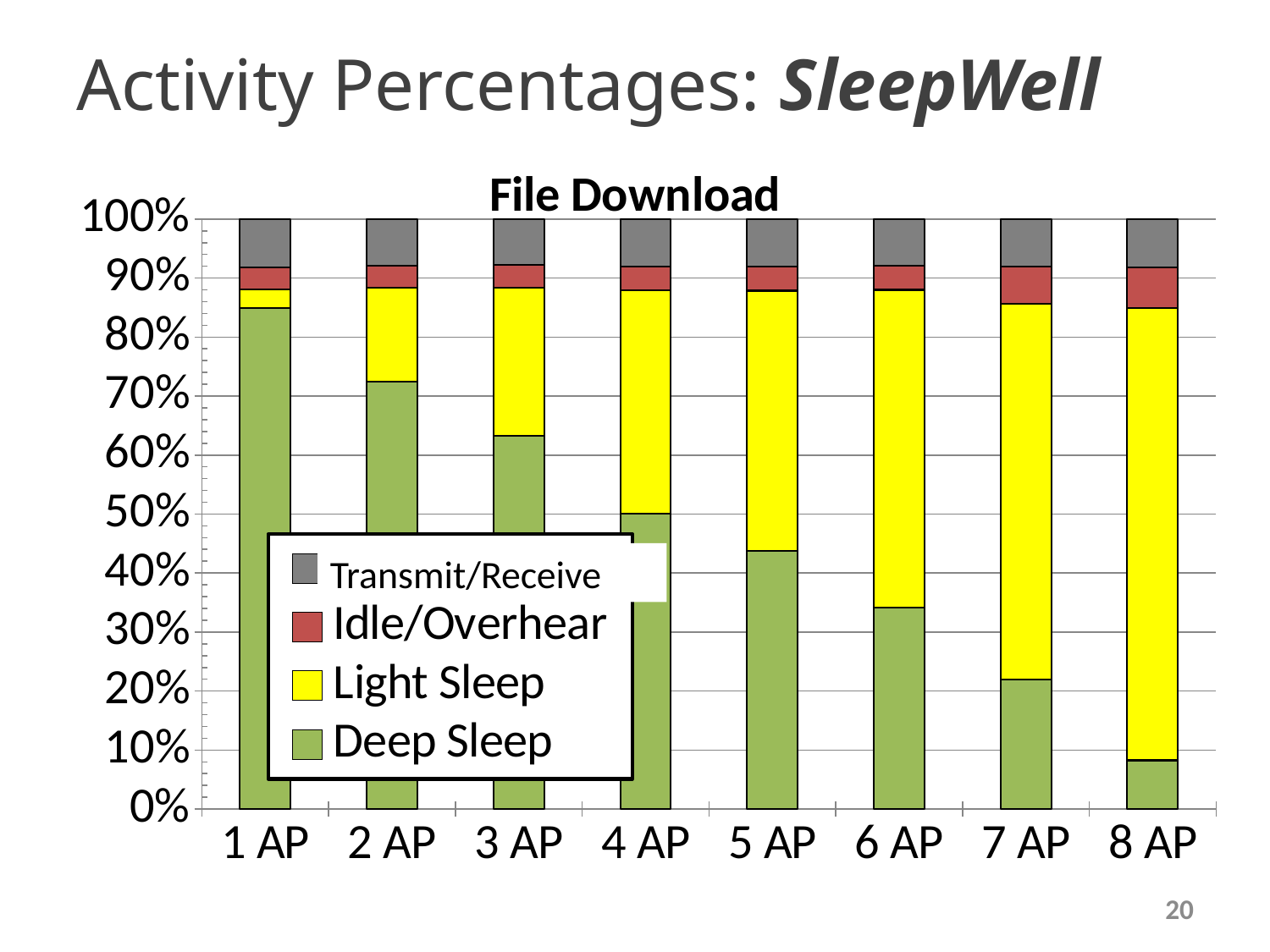
Is the Deep Sleep value for 2 AP greater or less than 60%? greater What is the title of the chart? File Download How many categories are shown on the x axis? 8 What kind of chart is shown on the slide? stacked bar chart Which has the larger Deep Sleep share, 3 AP or 6 AP? 3 AP Does the Deep Sleep share rise or fall as the number of APs increases from 1 AP to 8 AP? fall How many series does the legend list? 4 Is the Deep Sleep value for 1 AP greater or less than 80%? greater Is the Deep Sleep value for 5 AP greater or less than 50%? less Which category has the largest Deep Sleep share? 1 AP Which category has the smallest Deep Sleep share? 8 AP